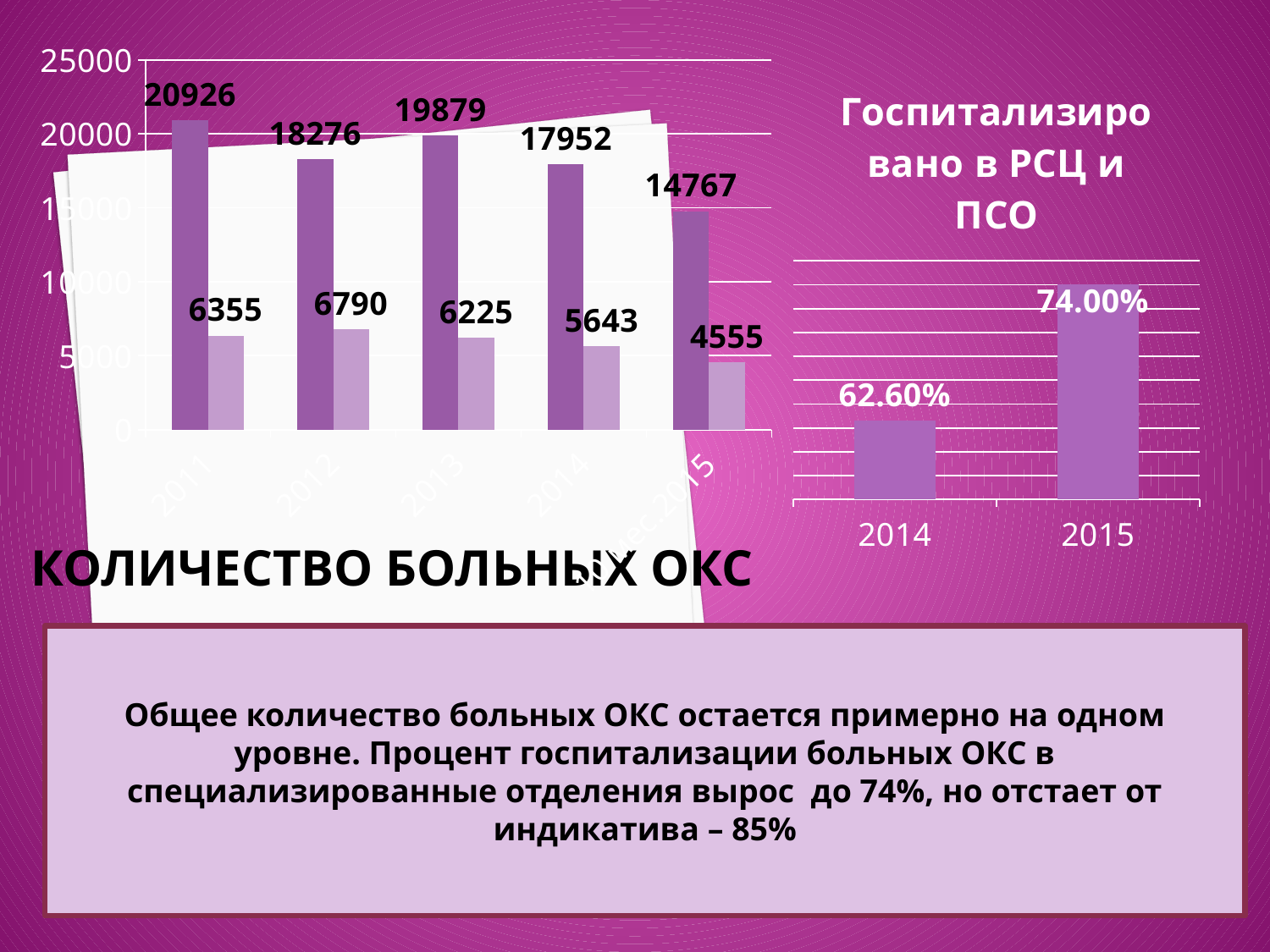
In the chart titled 'КОЛИЧЕСТВО БОЛЬНЫХ ОКС', which is larger: the light purple bar for 2012 or the light purple bar for 2014? 2012 In the chart titled 'КОЛИЧЕСТВО БОЛЬНЫХ ОКС', how many year categories are shown on the x axis? 5 In the chart titled 'КОЛИЧЕСТВО БОЛЬНЫХ ОКС', what kind of chart is it? Bar chart In the chart titled 'Госпитализировано в РСЦ и ПСО', what is the value for 2015? 74.00% In the chart titled 'КОЛИЧЕСТВО БОЛЬНЫХ ОКС', what is the value of the taller (dark purple) bar for 2011? 20926 In the chart titled 'КОЛИЧЕСТВО БОЛЬНЫХ ОКС', which year has the lowest value for the shorter (light purple) bars? 10 мес.2015 In the chart titled 'Госпитализировано в РСЦ и ПСО', what is the value for 2014? 62.60% In the chart titled 'КОЛИЧЕСТВО БОЛЬНЫХ ОКС', which year has the highest value for the taller (dark purple) bars? 2011 In the chart titled 'КОЛИЧЕСТВО БОЛЬНЫХ ОКС', what is the value of the taller (dark purple) bar for 2014? 17952 In the chart titled 'КОЛИЧЕСТВО БОЛЬНЫХ ОКС', what is the difference between the dark purple bar values for 2011 and 2012? 2650 In the chart titled 'КОЛИЧЕСТВО БОЛЬНЫХ ОКС', what is the value of the shorter (light purple) bar for 2013? 6225 In the chart titled 'Госпитализировано в РСЦ и ПСО', do the values rise or fall from 2014 to 2015? Rise